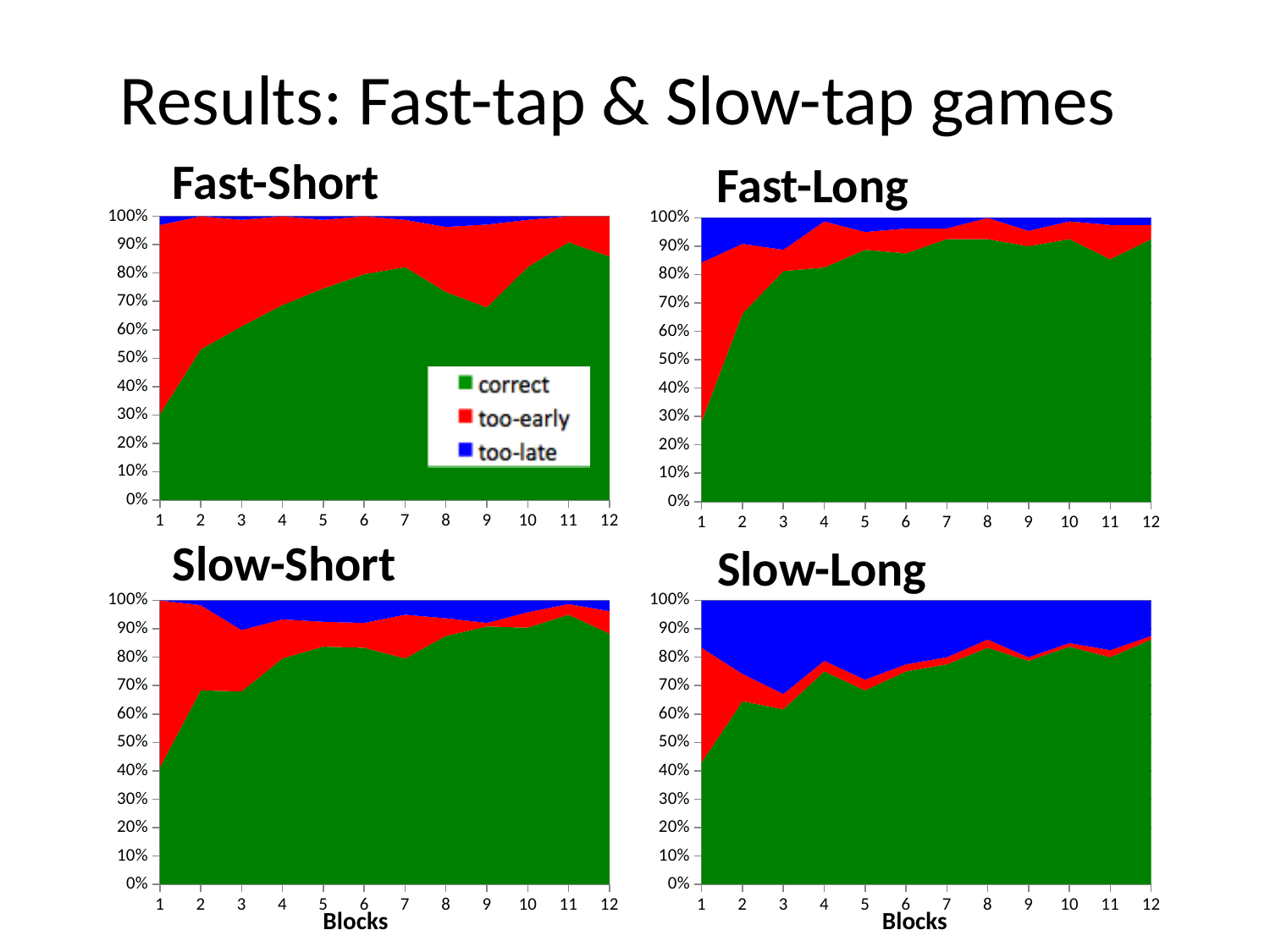
In the Fast-Long chart, is the correct share larger at block 1 or at block 12? Block 12 How many blocks are shown along the x axis of the Slow-Long chart? 12 In the Slow-Long chart, is the correct share at block 12 greater or less than 80%? greater In the Fast-Short chart, does the correct share rise or fall from block 1 to block 12? Rise In the Slow-Short chart, is the correct share at block 1 greater or less than 50%? less What is the x-axis label shown under the Slow-Short and Slow-Long charts? Blocks In the Fast-Short chart, is the correct share at block 1 greater or less than 40%? less What are the three legend entries on the Fast-Short chart? correct, too-early, too-late What kind of chart is the Fast-Short chart? Stacked area chart How many series does the legend on the Fast-Short chart list? 3 In the Slow-Long chart, does the too-late share rise or fall from block 1 to block 12? Fall